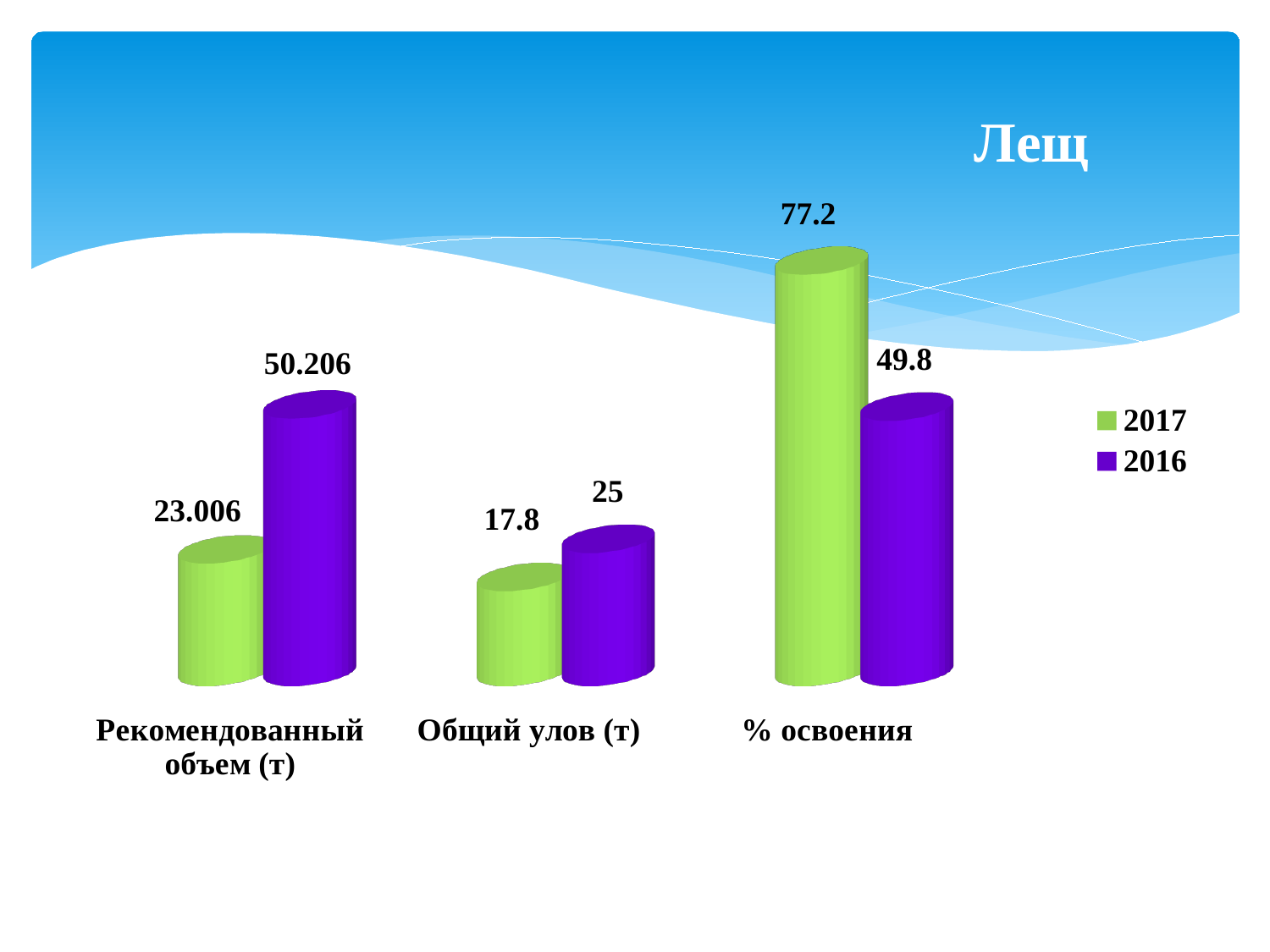
Which category has the highest value for the 2017 series? % освоения What type of chart is shown on the slide? Bar chart What is the value for 2017 in the '% освоения' category? 77.2 Which category has the lowest value for the 2016 series? Общий улов (т) What is the value for 2016 in the '% освоения' category? 49.8 What is the value for 2016 in the 'Рекомендованный объем (т)' category? 50.206 What is the value for 2016 in the 'Общий улов (т)' category? 25 How many series does the legend list? 2 What is the difference between the 2016 and 2017 values in the 'Общий улов (т)' category? 7.2 In the '% освоения' category, which year has the larger value, 2017 or 2016? 2017 What is the value for 2017 in the 'Рекомендованный объем (т)' category? 23.006 What is the value for 2017 in the 'Общий улов (т)' category? 17.8